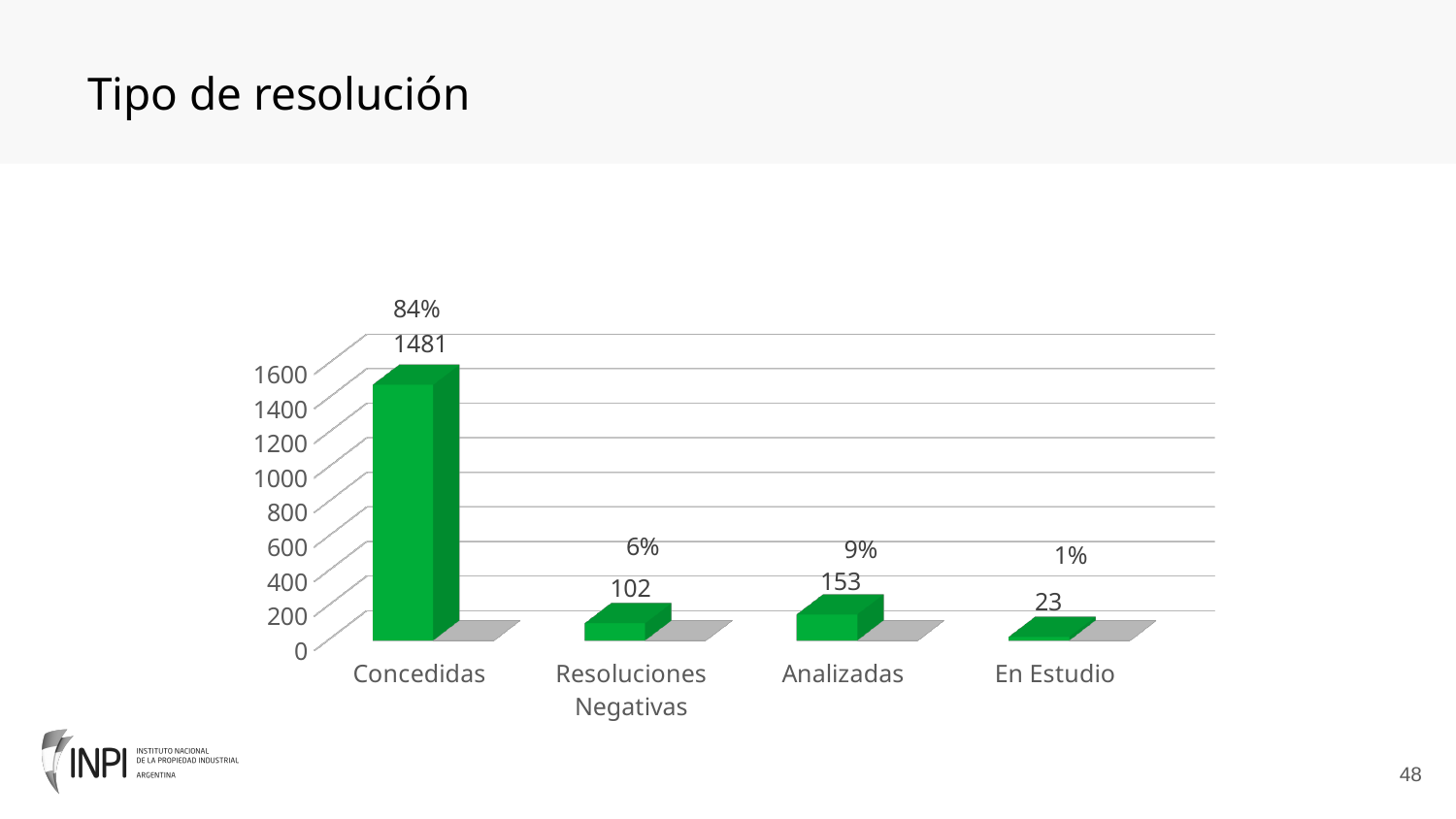
What is the difference between the values for Analizadas and Resoluciones Negativas? 51 Which is larger, the value for Analizadas or the value for Resoluciones Negativas? Analizadas How many categories are shown on the x axis? 4 What kind of chart is shown on the slide? Bar chart What is the value for Analizadas? 153 What is the value for En Estudio? 23 What is the value for Concedidas? 1481 Which category has the lowest value? En Estudio What percentage is shown above the Concedidas bar? 84% What is the title of the slide? Tipo de resolución What is the value for Resoluciones Negativas? 102 Which category has the highest value? Concedidas